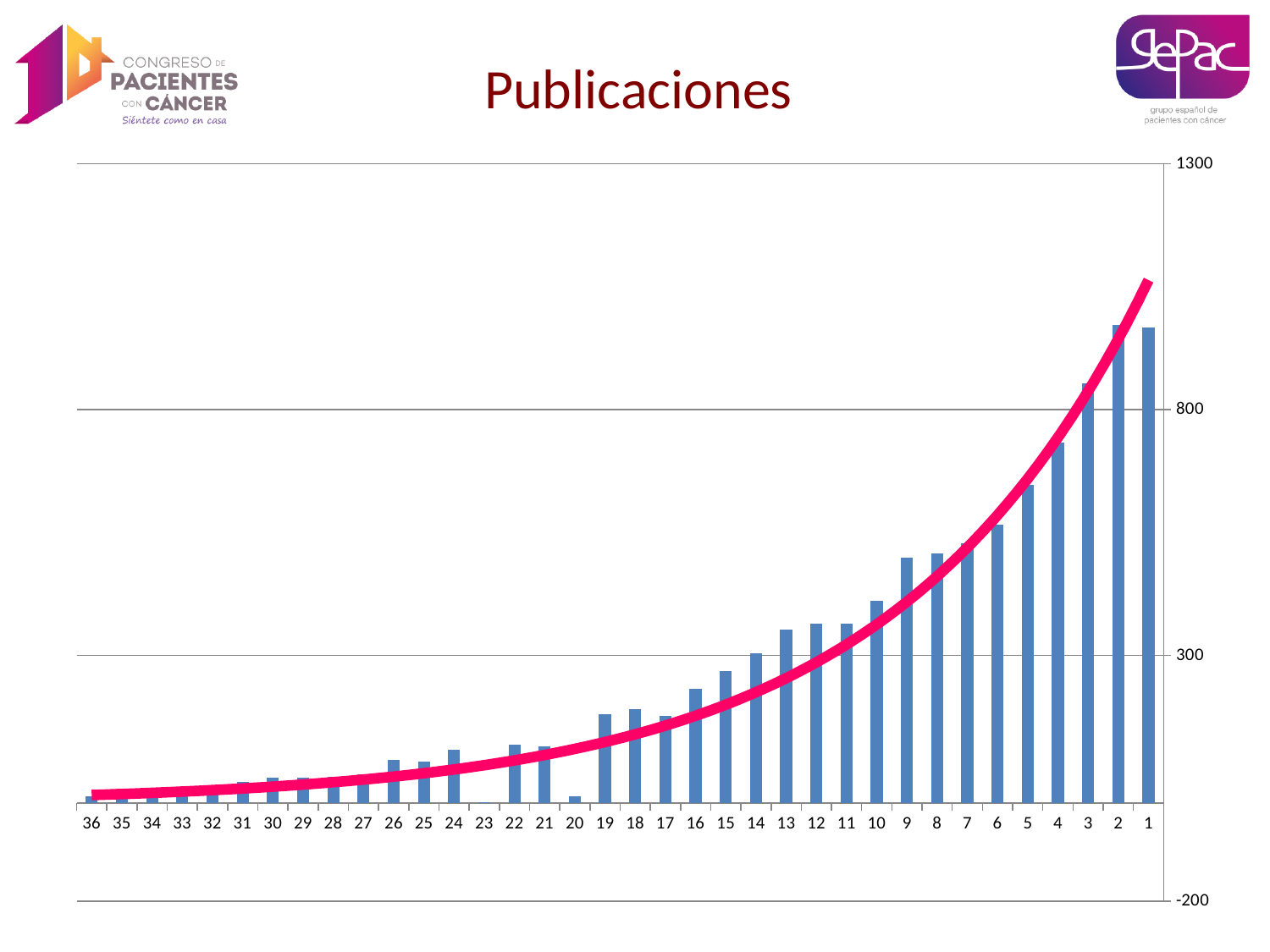
Which has the larger value, category 9 or category 15? 9 Is the value for category 9 greater or less than 800? less Is the value for category 13 greater or less than 300? greater How many categories are shown on the x axis of the chart? 36 Is the value for category 4 greater or less than 800? less What is the title of the chart? Publicaciones Which has the larger value, category 1 or category 36? 1 Do the bar values generally rise or fall moving from left to right along the x axis? rise What kind of chart is shown on the slide? bar chart What is the highest value shown on the y axis? 1300